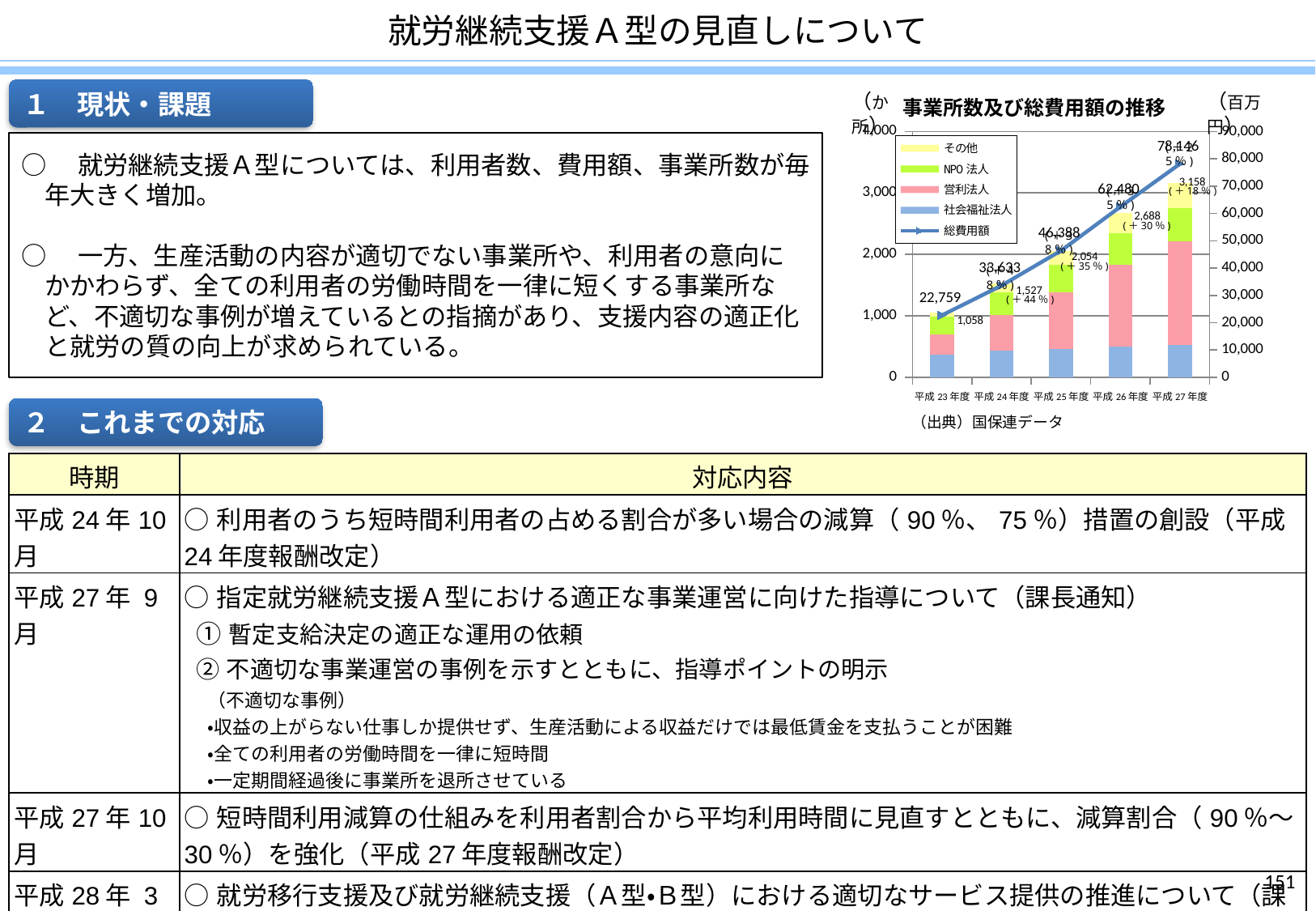
What is the 総費用額 value for 平成23年度? 22,759 What is the difference between the 総費用額 values for 平成27年度 and 平成23年度? 55,387 Do the 総費用額 values rise or fall from 平成23年度 to 平成27年度? Rise How many entries does the chart's legend list? 5 What is the total number of 事業所 (bar total) for 平成23年度? 1,058 What is the growth rate shown next to the bar total for 平成24年度? +44% How many fiscal years are shown on the x axis of the chart? 5 What is the difference between the bar totals for 平成27年度 and 平成23年度? 2,100 What kind of chart is shown on the slide? Stacked bar chart with a line Which fiscal year has the highest bar total? 平成27年度 What is the total number of 事業所 (bar total) for 平成27年度? 3,158 What is the 総費用額 value for 平成27年度? 78,146